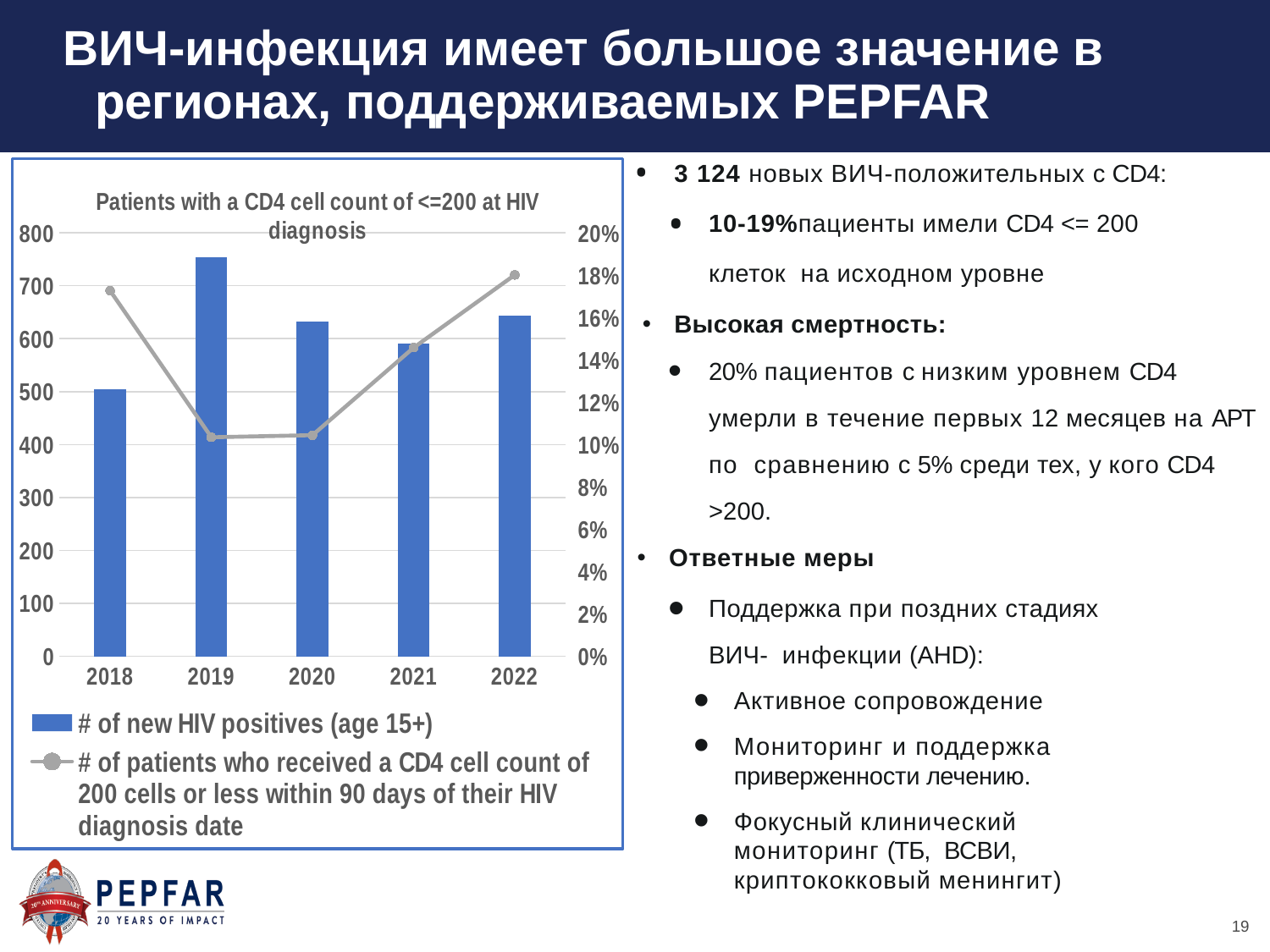
How many series does the chart legend list? 2 Which year has the lowest number of new HIV positives (age 15+)? 2018 Is the number of new HIV positives (age 15+) in 2018 greater or less than 600? less How many years are shown on the x axis of the chart? 5 Is the number of new HIV positives (age 15+) in 2019 greater or less than 700? greater Is the number of new HIV positives (age 15+) in 2022 greater or less than 600? greater Which year has the highest number of new HIV positives (age 15+)? 2019 What is the title of the chart? Patients with a CD4 cell count of <=200 at HIV diagnosis Does the line for patients who received a CD4 cell count of 200 cells or less rise or fall from 2020 to 2022? rise Which year has more new HIV positives (age 15+), 2020 or 2021? 2020